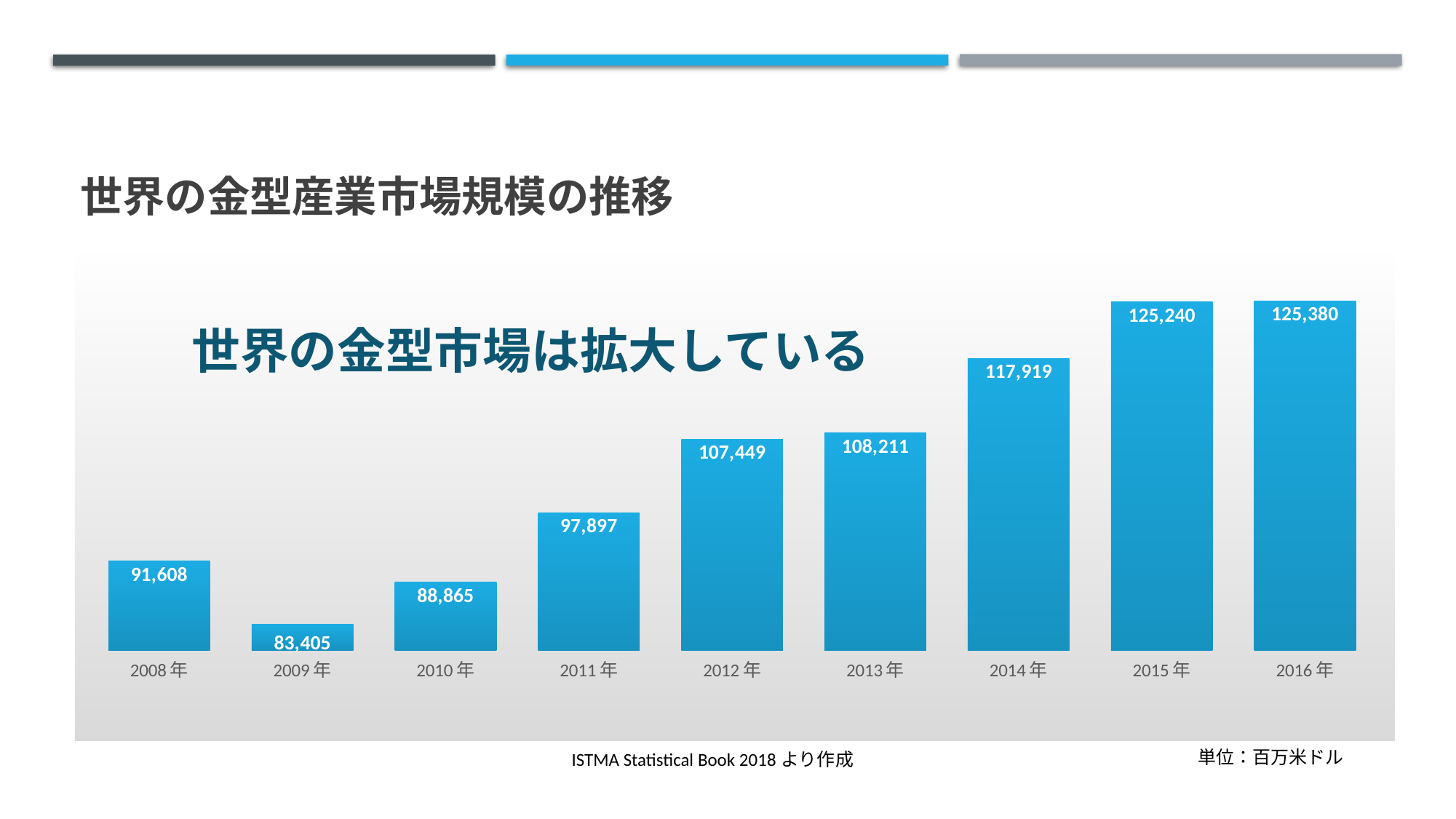
Which is larger, the value for 2010年 or the value for 2011年? 2011年 What kind of chart is shown on the slide? Bar chart What is the difference between the values for 2016年 and 2008年? 33,772 What is the value for 2016年 (2016)? 125,380 Which year has the lowest value? 2009年 What unit is stated for the values on the slide? 百万米ドル What is the difference between the values for 2014年 and 2013年? 9,708 How many years are shown on the x axis? 9 What is the value for 2008年 (2008)? 91,608 What is the value for 2013年 (2013)? 108,211 Do the values generally rise or fall from 2009年 to 2016年? Rise Which year has the highest value? 2016年